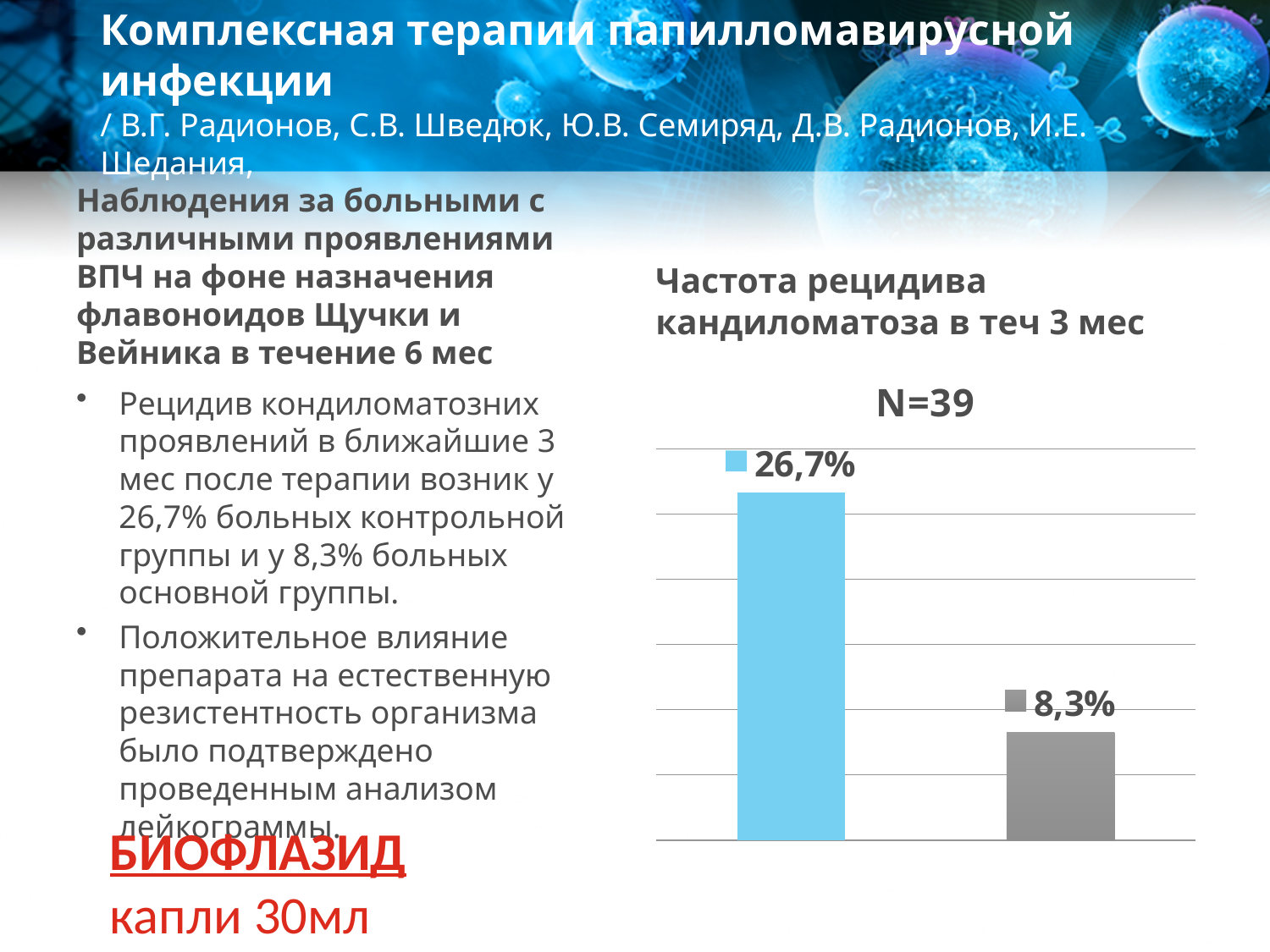
Which bar is higher, the blue (left) bar or the grey (right) bar? the blue (left) bar What is the difference between the two values shown in the chart? 18,4% Do the bar values rise or fall from left to right in the chart? fall What value is labelled on the grey (right) bar of the chart? 8,3% What is the title shown above the chart? N=39 What heading is written above the chart on the right side of the slide? Частота рецидива кандиломатоза в теч 3 мес What is the highest value shown in the chart? 26,7% What is the lowest value shown in the chart? 8,3% What kind of chart is shown on the slide? bar chart How many bars are plotted in the chart? 2 What value is labelled on the blue (left) bar of the chart? 26,7%